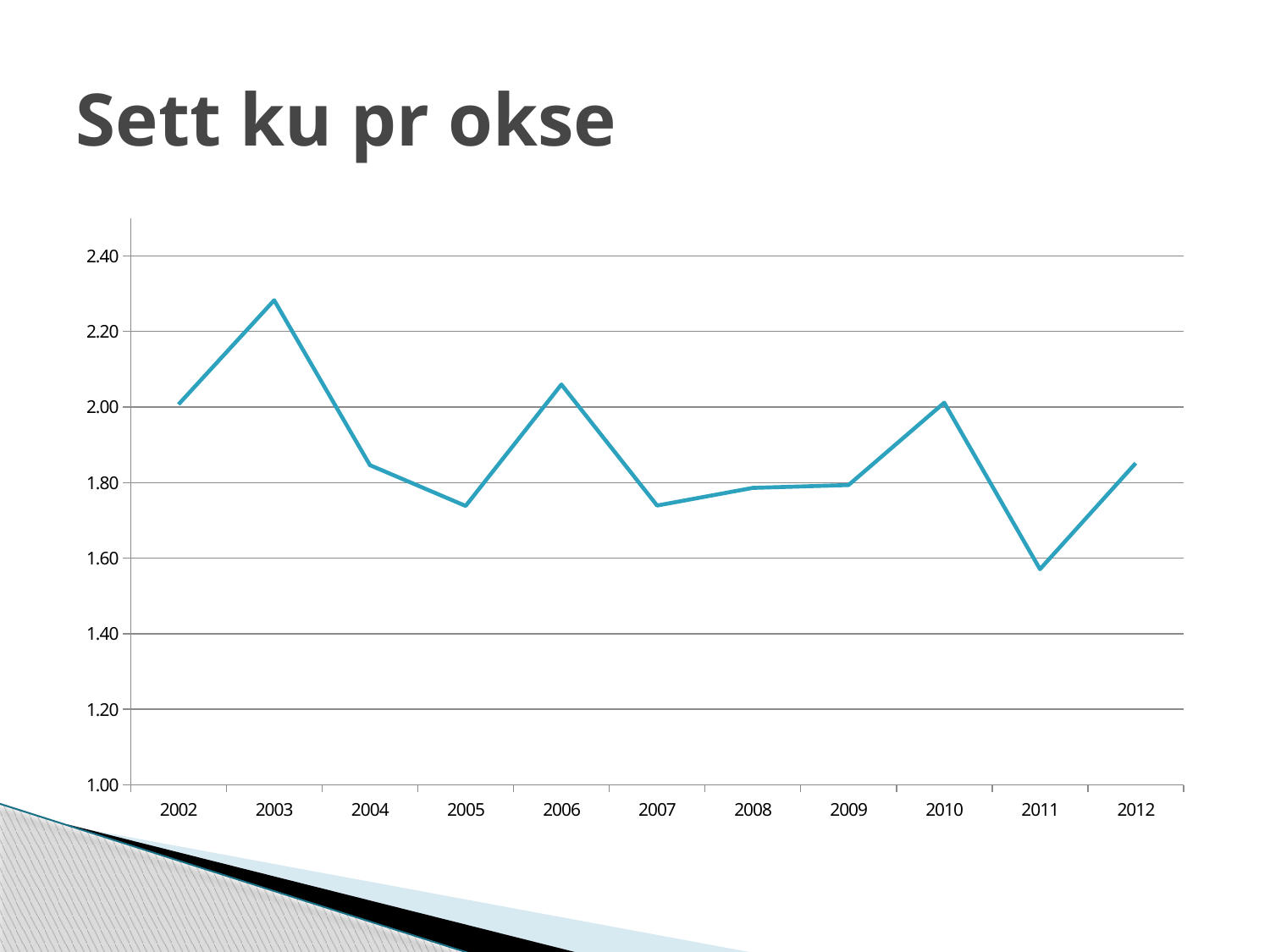
Is the value for 2006 greater or less than 2.00? greater What kind of chart is shown on the slide? line chart Overall, does the value rise or fall from 2002 to 2012? fall What is the title of the chart? Sett ku pr okse How many years are plotted on the x axis? 11 Which year has the highest value? 2003 Which year has the larger value, 2003 or 2006? 2003 Is the value for 2003 greater or less than 2.20? greater Which year has the lowest value? 2011 Is the value for 2011 greater or less than 1.60? less Which year has the larger value, 2004 or 2011? 2004